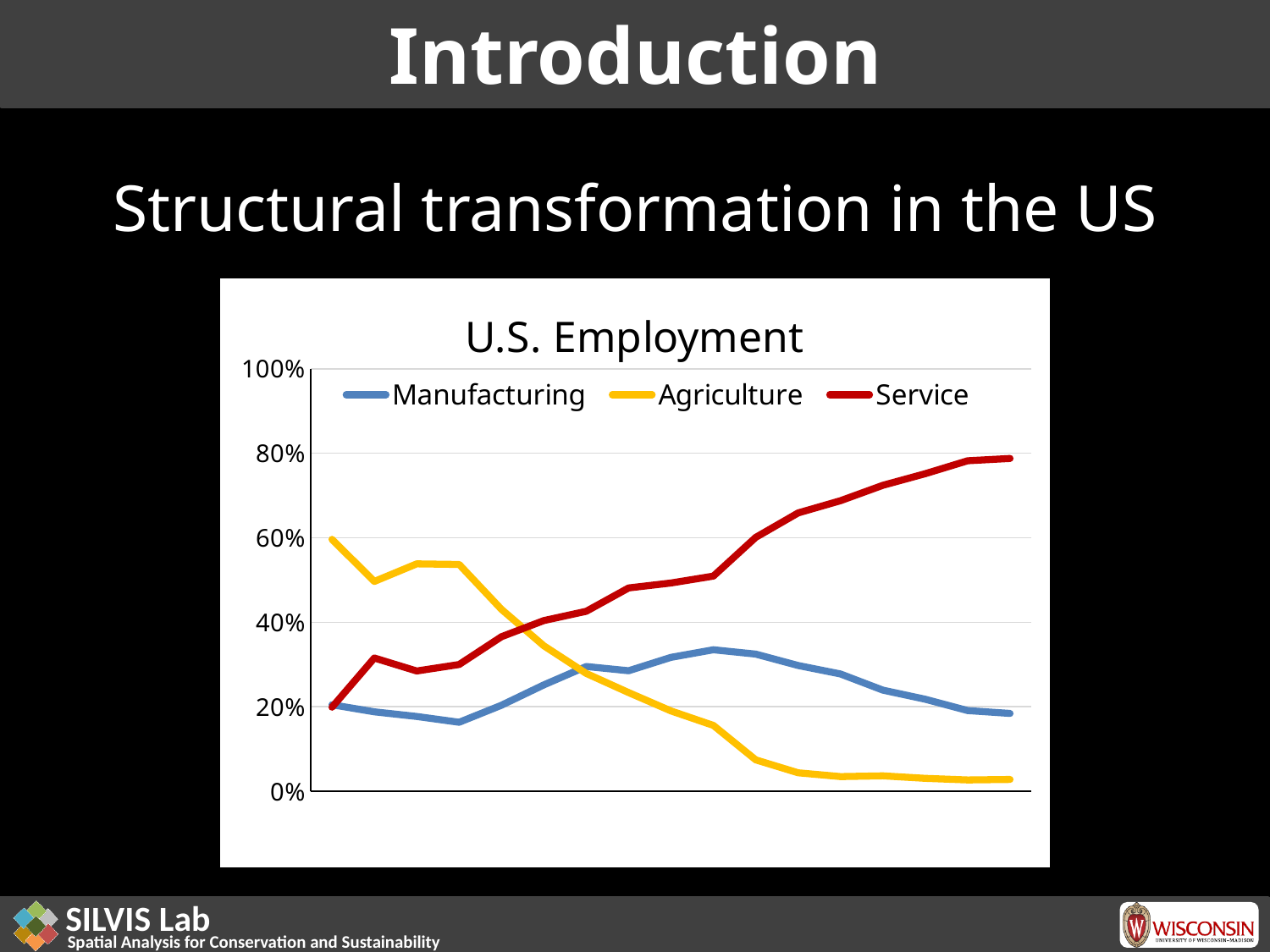
Which series has the lowest value at the right end of the chart? Agriculture At the right end of the chart, which is larger, Manufacturing or Agriculture? Manufacturing Which series has the highest value at the right end of the chart? Service Does the Agriculture line rise or fall along the x axis? falls Which series has the highest value at the left end of the chart? Agriculture What kind of chart is shown on the slide? line chart What is the title of the chart? U.S. Employment How many series does the chart's legend list? 3 Is the Agriculture value at the right end of the chart greater or less than 20%? less Is the Service value at the right end of the chart greater or less than 60%? greater Which series is drawn in red? Service Does the Service line rise or fall along the x axis? rises